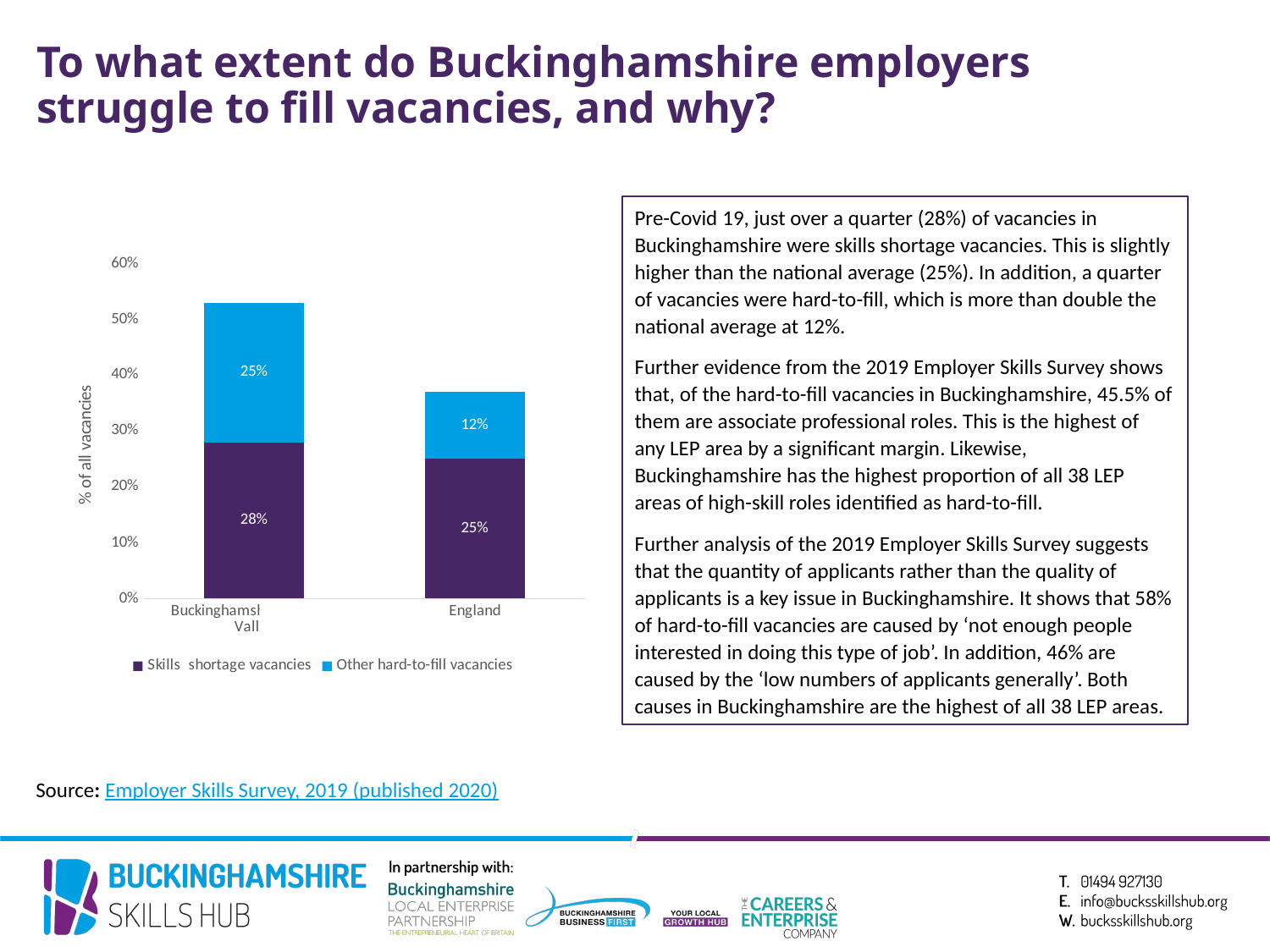
What is the value for Other hard-to-fill vacancies for England? 12% What is the label on the vertical axis of the chart? % of all vacancies How many series does the legend list? 2 What is the value for Skills shortage vacancies for Buckinghamshire? 28% What is the total of the stacked bar for Buckinghamshire? 53% What is the value for Skills shortage vacancies for England? 25% What is the difference between the Other hard-to-fill vacancies values for Buckinghamshire and England? 13% What is the value for Other hard-to-fill vacancies for Buckinghamshire? 25% What kind of chart is shown on the slide? Stacked bar chart Is the total stacked bar for England greater or less than 40%? less What is the total of the stacked bar for England? 37% Which area has the larger Skills shortage vacancies value, Buckinghamshire or England? Buckinghamshire